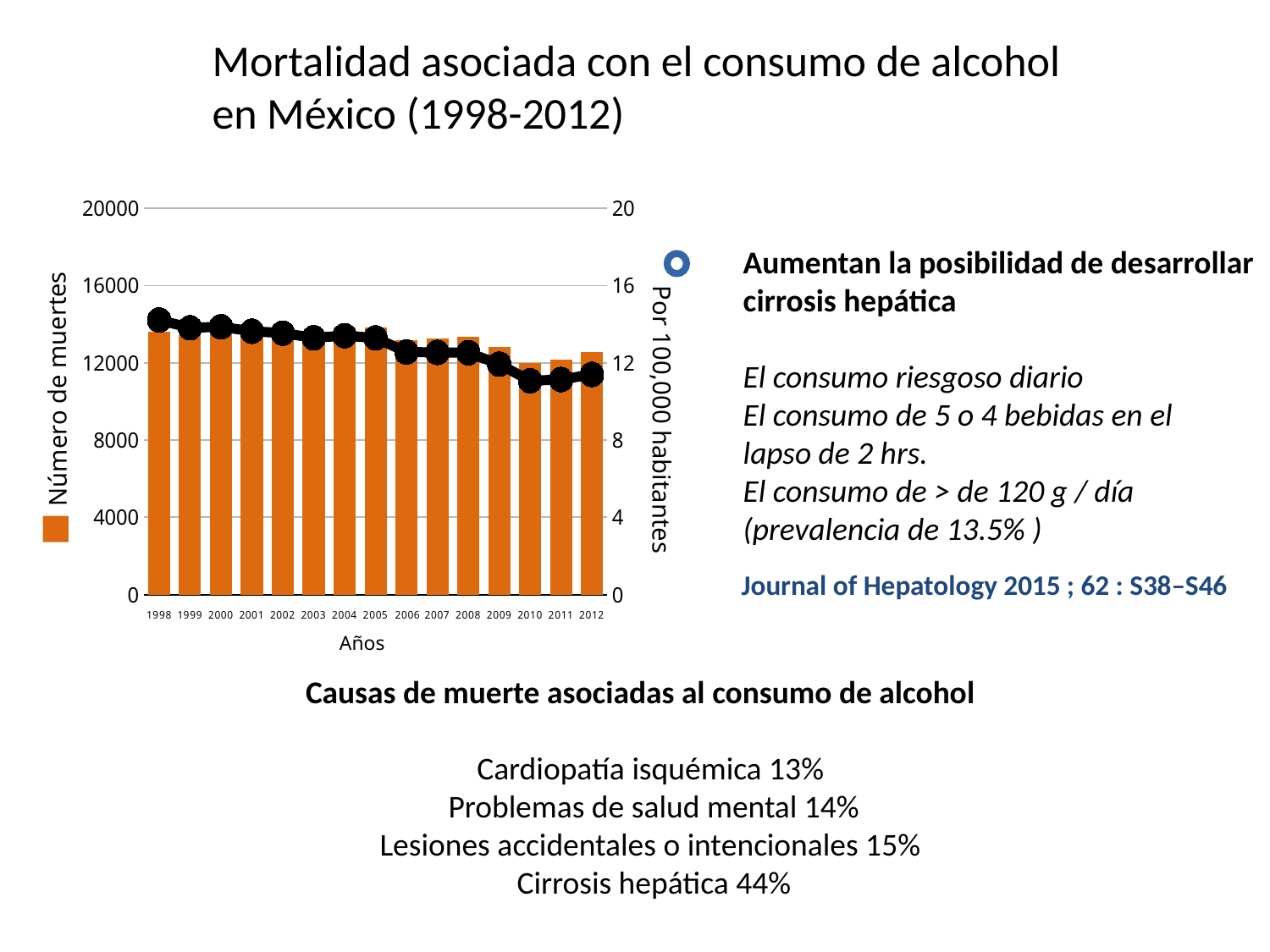
How many years are plotted along the x axis of the chart? 15 What is the title of the x axis of the chart? Años What kind of chart is shown on the slide? A bar chart with a line overlay Is the line value (Por 100,000 habitantes) for 1998 greater or less than 12? greater Do the bar values (Número de muertes) generally rise or fall from 1998 to 2012? Fall Which year has the larger bar value (Número de muertes), 1998 or 2010? 1998 Is the bar value (Número de muertes) for 2005 greater or less than 16000? less Does the line (Por 100,000 habitantes) generally rise or fall from 1998 to 2012? Fall Is the line value (Por 100,000 habitantes) for 2010 greater or less than 12? less Which year has the larger line value (Por 100,000 habitantes), 1998 or 2012? 1998 What is the title of the left vertical axis of the chart? Número de muertes